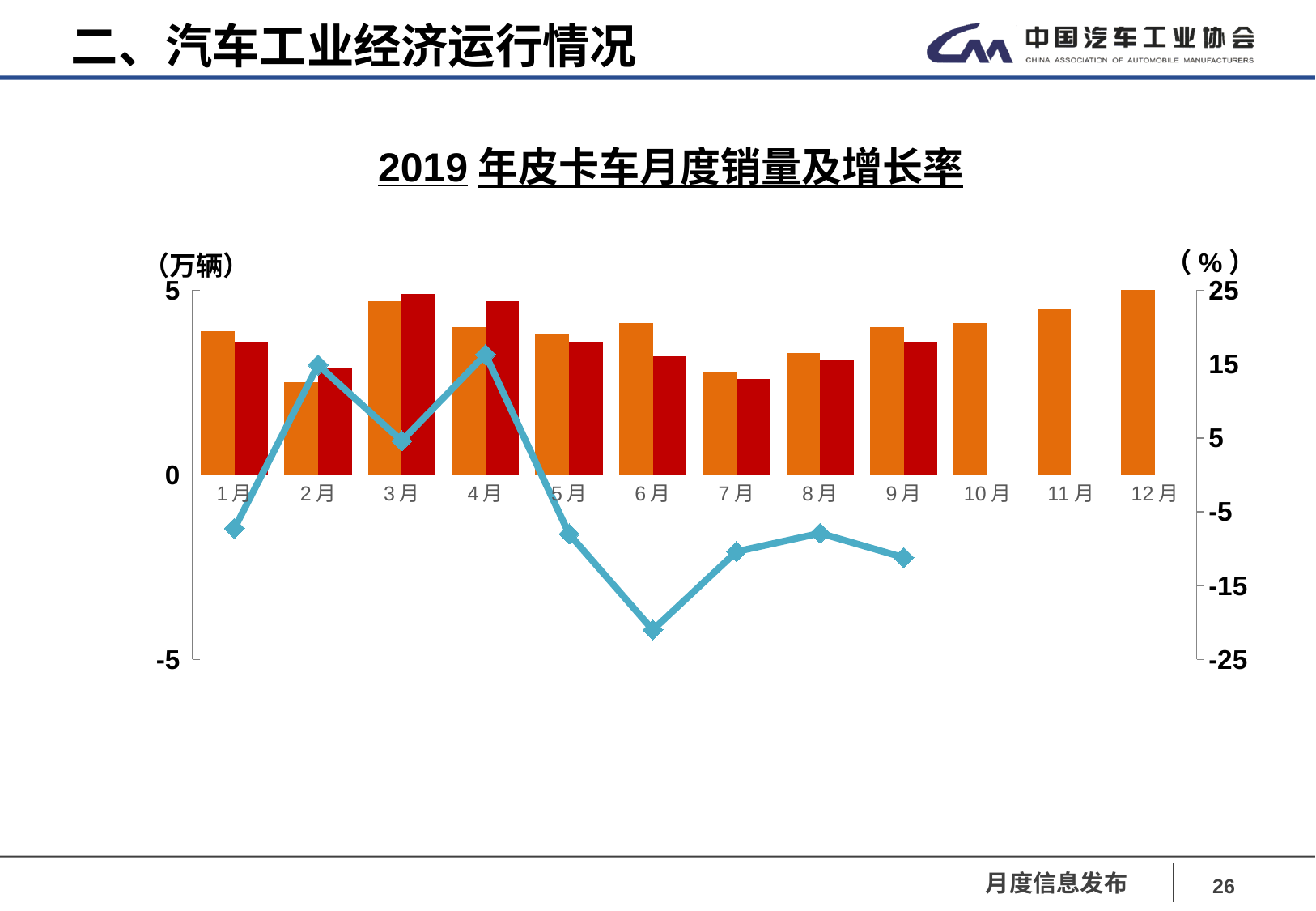
How many months are shown on the x axis of the chart? 12 Is the growth-rate line value for 6月 greater or less than -15? less Which month has the shortest red bar? 7月 Do the orange bars rise or fall from 9月 to 12月? Rise In which month does the growth-rate line reach its lowest point? 6月 Which month has the tallest orange bar? 12月 What unit is shown on the left axis of the chart? 万辆 Is the orange bar for 3月 taller than the orange bar for 7月? Yes What kind of chart is shown on the slide? A combination bar and line chart Does the growth-rate line rise or fall from 4月 to 6月? Fall Which month has the shortest orange bar? 2月 Is the growth-rate line value for 9月 greater or less than -5? less